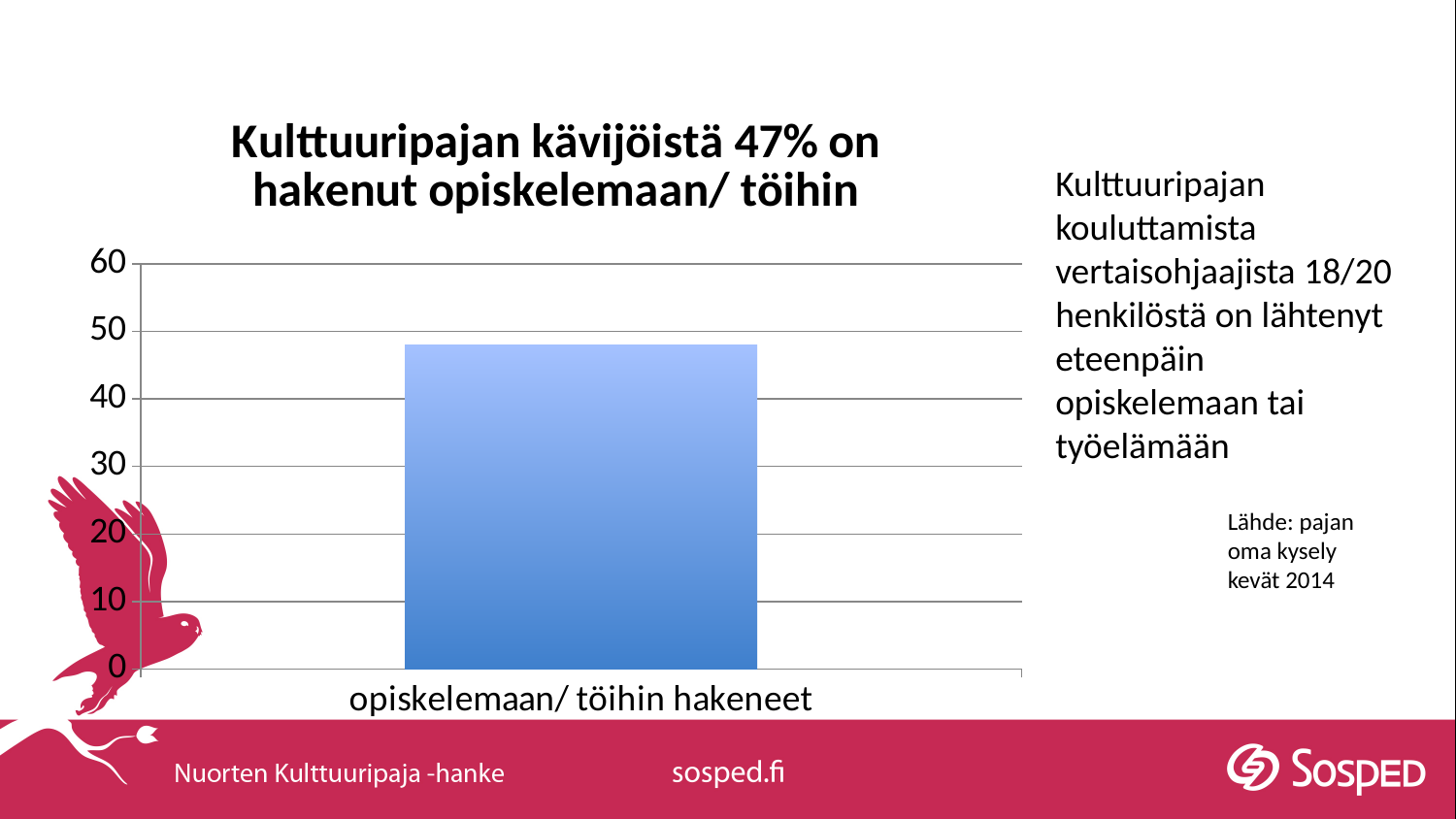
What is the highest value shown on the y axis? 60 Is the value for opiskelemaan/ töihin hakeneet greater or less than 40? greater How many bars does the chart show? 1 Is the value for opiskelemaan/ töihin hakeneet greater or less than 60? less What kind of chart is shown on the slide? bar chart What is the label of the category on the x axis? opiskelemaan/ töihin hakeneet Is the value for opiskelemaan/ töihin hakeneet greater or less than 30? greater